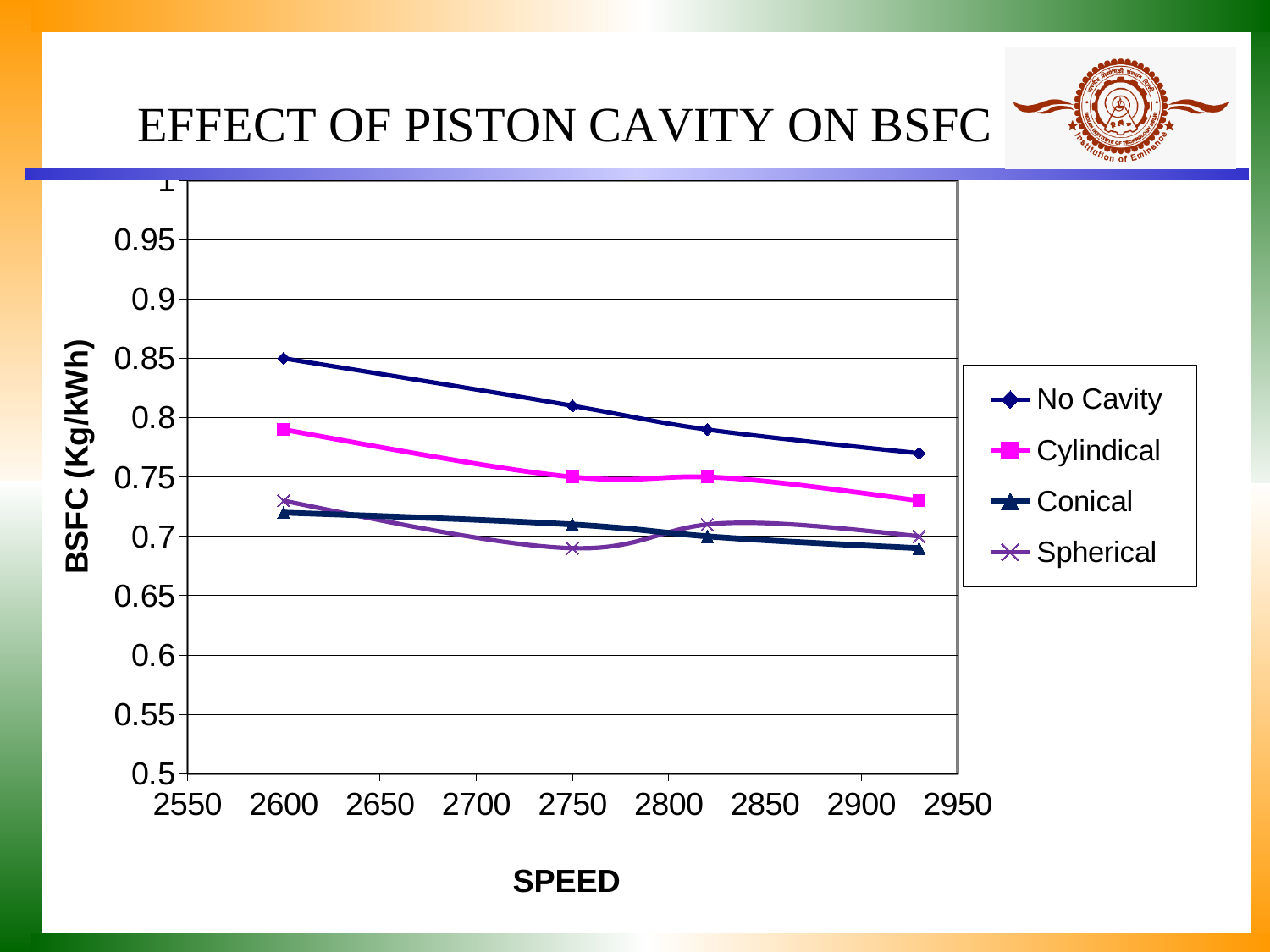
What is the BSFC value for Cylindical at a speed of 2750? 0.75 How many data points are plotted for the No Cavity series? 4 Which series has the highest BSFC values across the speed range? No Cavity Does the BSFC for No Cavity rise or fall as speed increases? fall What is the BSFC value for No Cavity at a speed of 2600? 0.85 What is the label of the y axis? BSFC (Kg/kWh) Is the BSFC value for Spherical at a speed of 2750 greater or less than 0.7? less What is the title of the chart? EFFECT OF PISTON CAVITY ON BSFC How many series does the legend list? 4 At a speed of 2600, which is larger, the BSFC for No Cavity or for Conical? No Cavity Is the BSFC value for Conical at a speed of 2600 greater or less than 0.75? less What kind of chart is shown on the slide? line chart